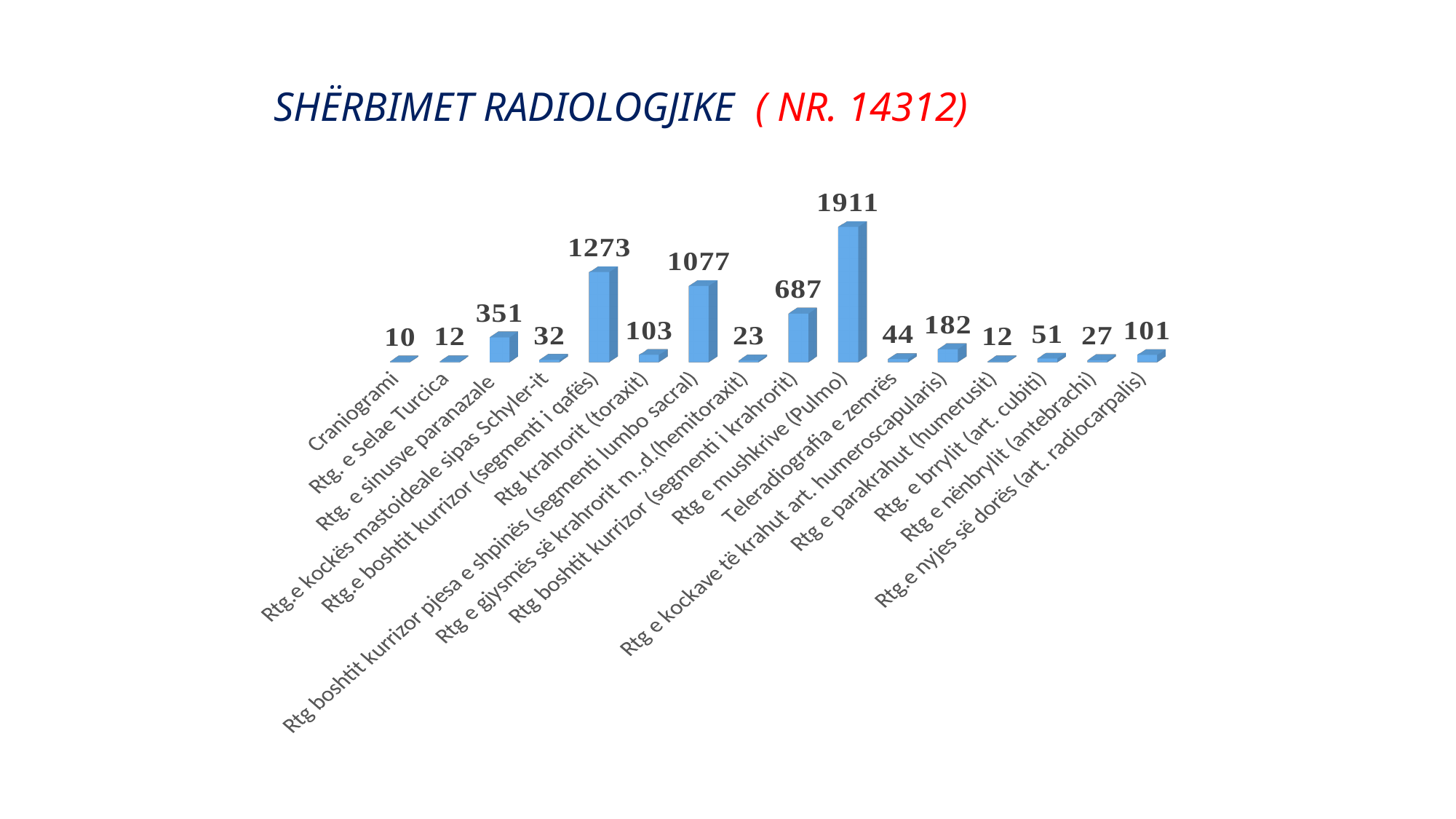
What is the title of the slide? SHËRBIMET RADIOLOGJIKE ( NR. 14312) What is the value for Rtg.e nyjes së dorës (art. radiocarpalis)? 101 What is the value for Teleradiografia e zemrës? 44 What kind of chart is shown on the slide? Bar chart How many categories are shown in the chart? 16 What is the value for Rtg e mushkrive (Pulmo)? 1911 What is the difference between the values for Rtg.e boshtit kurrizor (segmenti i qafës) and Rtg boshtit kurrizor pjesa e shpinës (segmenti lumbo sacral)? 196 Which category has the highest value? Rtg e mushkrive (Pulmo) Which category has the lowest value? Craniogrami What is the value for Rtg. e sinusve paranazale? 351 Which is larger, the value for Rtg krahrorit (toraxit) or the value for Rtg e kockave të krahut art. humeroscapularis? Rtg e kockave të krahut art. humeroscapularis What is the difference between the values for Rtg e mushkrive (Pulmo) and Rtg boshtit kurrizor (segmenti i krahrorit)? 1224